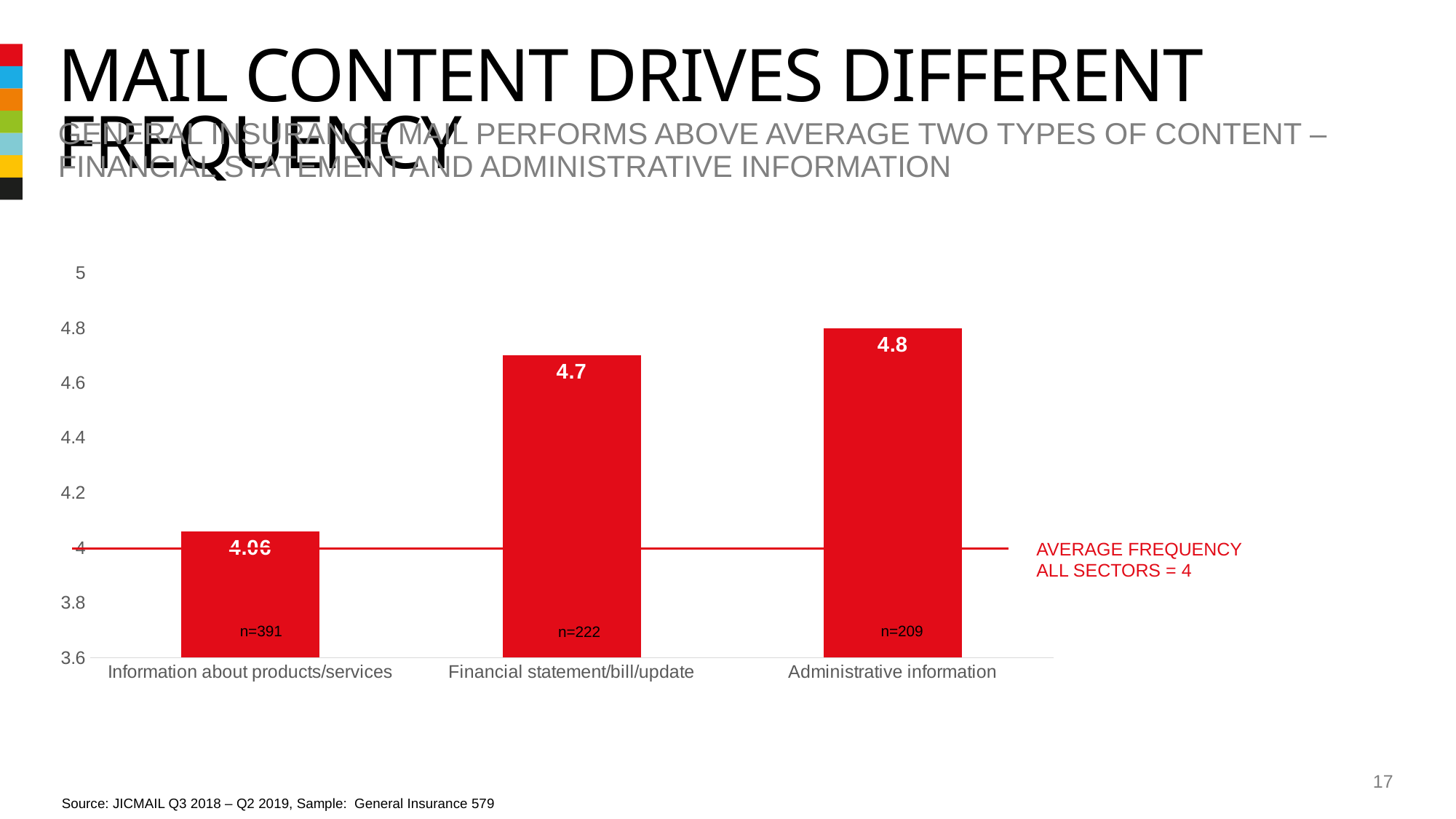
What is the value for Financial statement/bill/update? 4.7 What is the value for Administrative information? 4.8 Which is larger, the value for Financial statement/bill/update or the value for Information about products/services? Financial statement/bill/update What value does the horizontal red line labelled 'Average frequency all sectors' mark? 4 What is the value for Information about products/services? 4.06 Is the value for Financial statement/bill/update greater or less than 4.4? greater Which category has the lowest value? Information about products/services What is the sample size (n) shown for Information about products/services? n=391 What kind of chart is shown on the slide? bar chart What is the difference between the values for Administrative information and Financial statement/bill/update? 0.1 Which category has the highest value? Administrative information How many categories are shown on the chart? 3